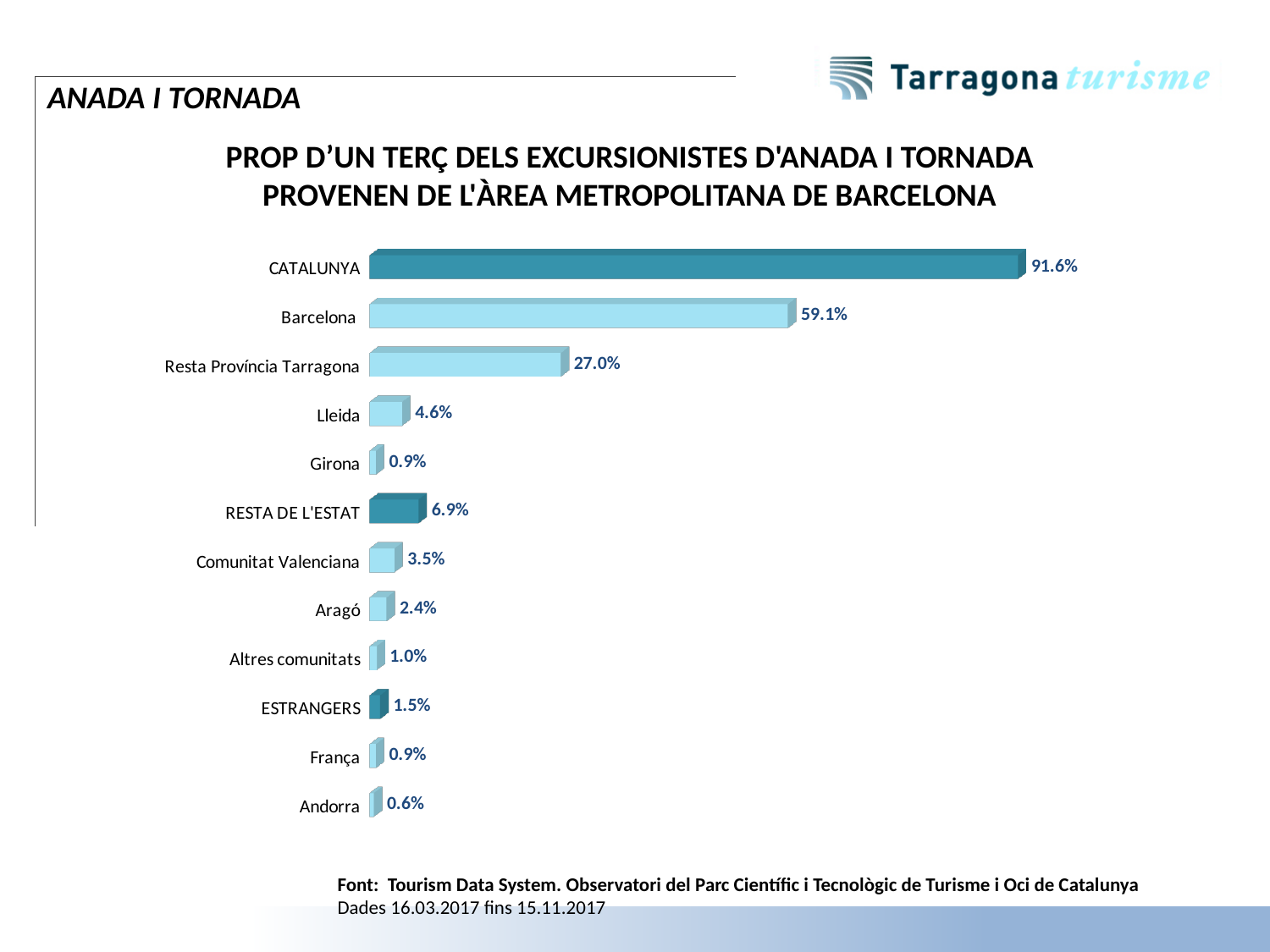
Which category has the lowest value? Andorra What is the value for Resta Província Tarragona? 27.0% What is the difference between the values for CATALUNYA and Barcelona? 32.5% What is the value for Comunitat Valenciana? 3.5% What is the value for Barcelona? 59.1% How many categories are shown in the chart? 12 What is the difference between the values for Lleida and Aragó? 2.2% Which is larger, the value for RESTA DE L'ESTAT or the value for Lleida? RESTA DE L'ESTAT Which category has the highest value? CATALUNYA What is the source cited below the chart? Tourism Data System. Observatori del Parc Científic i Tecnològic de Turisme i Oci de Catalunya What is the value for ESTRANGERS? 1.5% What kind of chart is shown on the slide? Bar chart